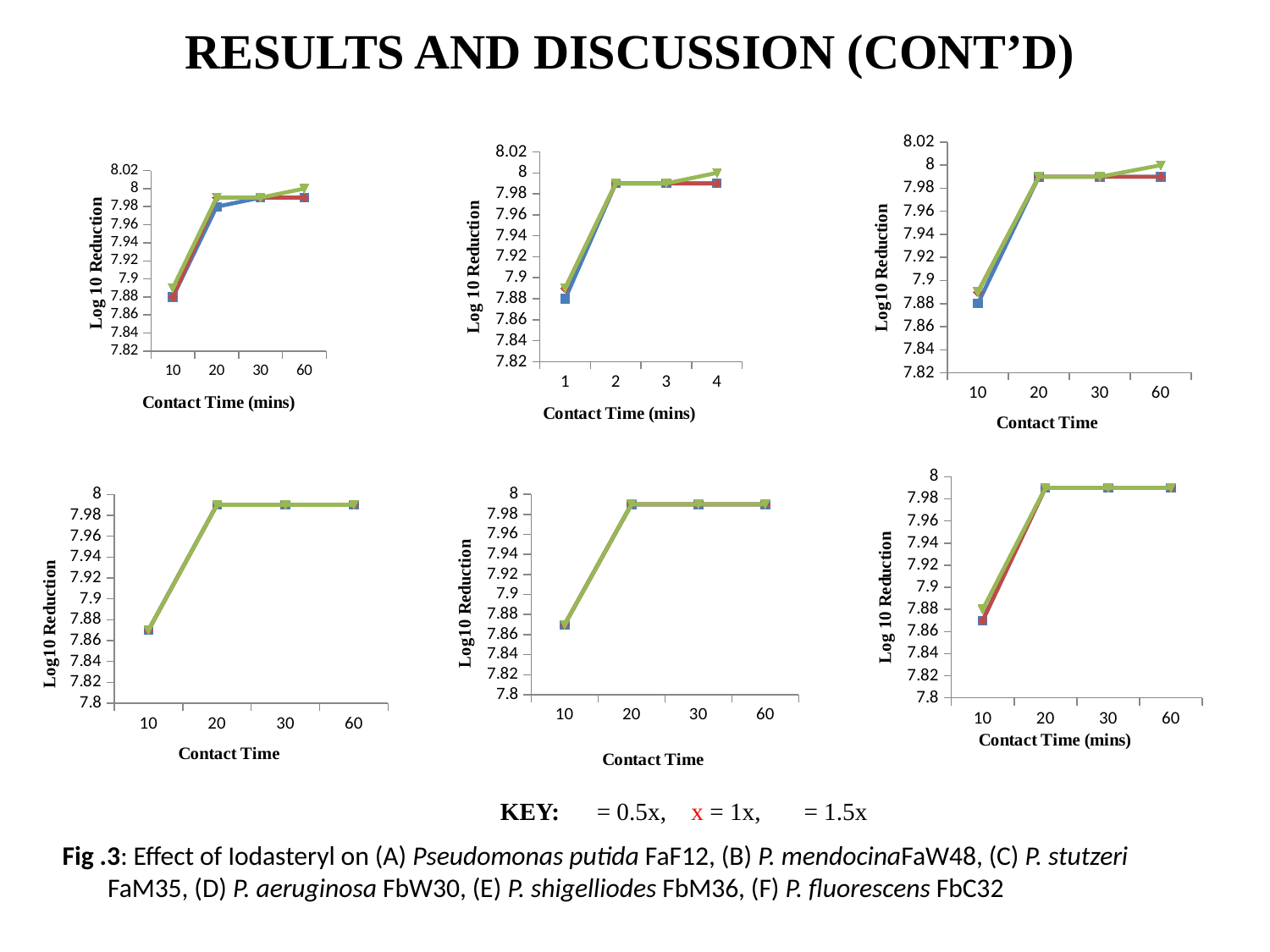
What kind of chart is the top-left chart on the slide? line chart How many charts are shown on the slide? 6 In the bottom-left chart, is the value at a contact time of 20 greater or less than 7.96? greater In the top-right chart, is the value at a contact time of 10 greater or less than 7.92? less In the bottom-left chart, is the value at a contact time of 10 greater or less than 7.9? less In the bottom-left chart, do the values rise or fall from a contact time of 10 to 20 minutes? rise What is the y-axis title of the bottom-right chart? Log 10 Reduction What are the x-axis tick labels on the top-middle chart? 1, 2, 3, 4 In the bottom-middle chart, which contact time has the lowest value? 10 In the top-left chart, how many contact time points are plotted along the x axis? 4 In the top-left chart, which is larger: the value at a contact time of 10 or the value at a contact time of 30? 30